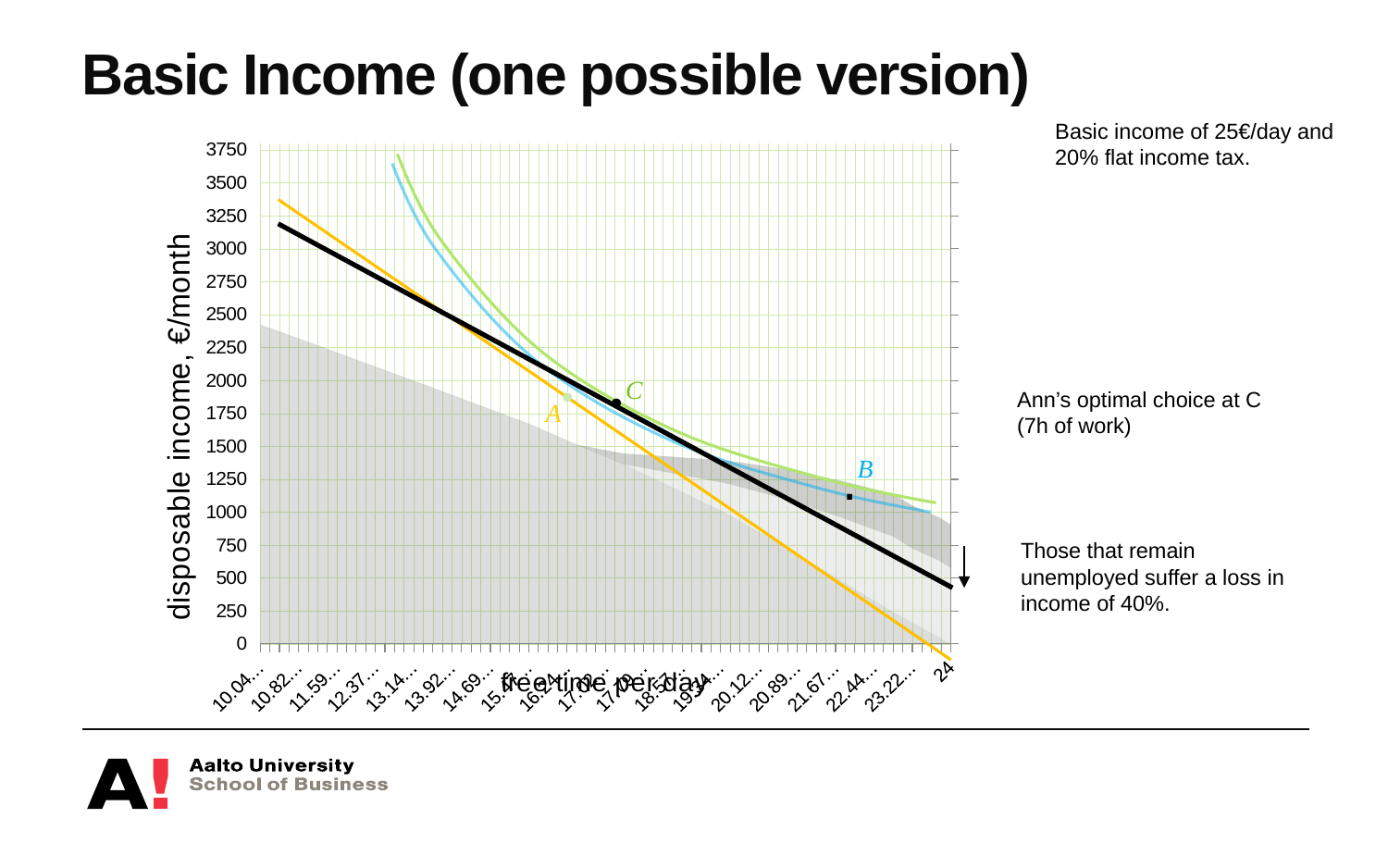
What is the highest tick value shown on the vertical axis? 3750 Is the disposable income at point C greater or less than 1500? greater What is the title of the horizontal axis of the chart? free time per day What kind of chart is shown on the slide? area chart What is the last tick label shown on the horizontal axis? 24 Is the disposable income at point B greater or less than 1000? greater What is the title of the vertical axis of the chart? disposable income, €/month Is the disposable income at point B greater or less than 1250? less Which of the labelled points A, B and C has the lowest disposable income? B Does the black straight line rise or fall as free time per day increases along the x axis? fall How many labelled points (A, B, C) are marked on the chart? 3